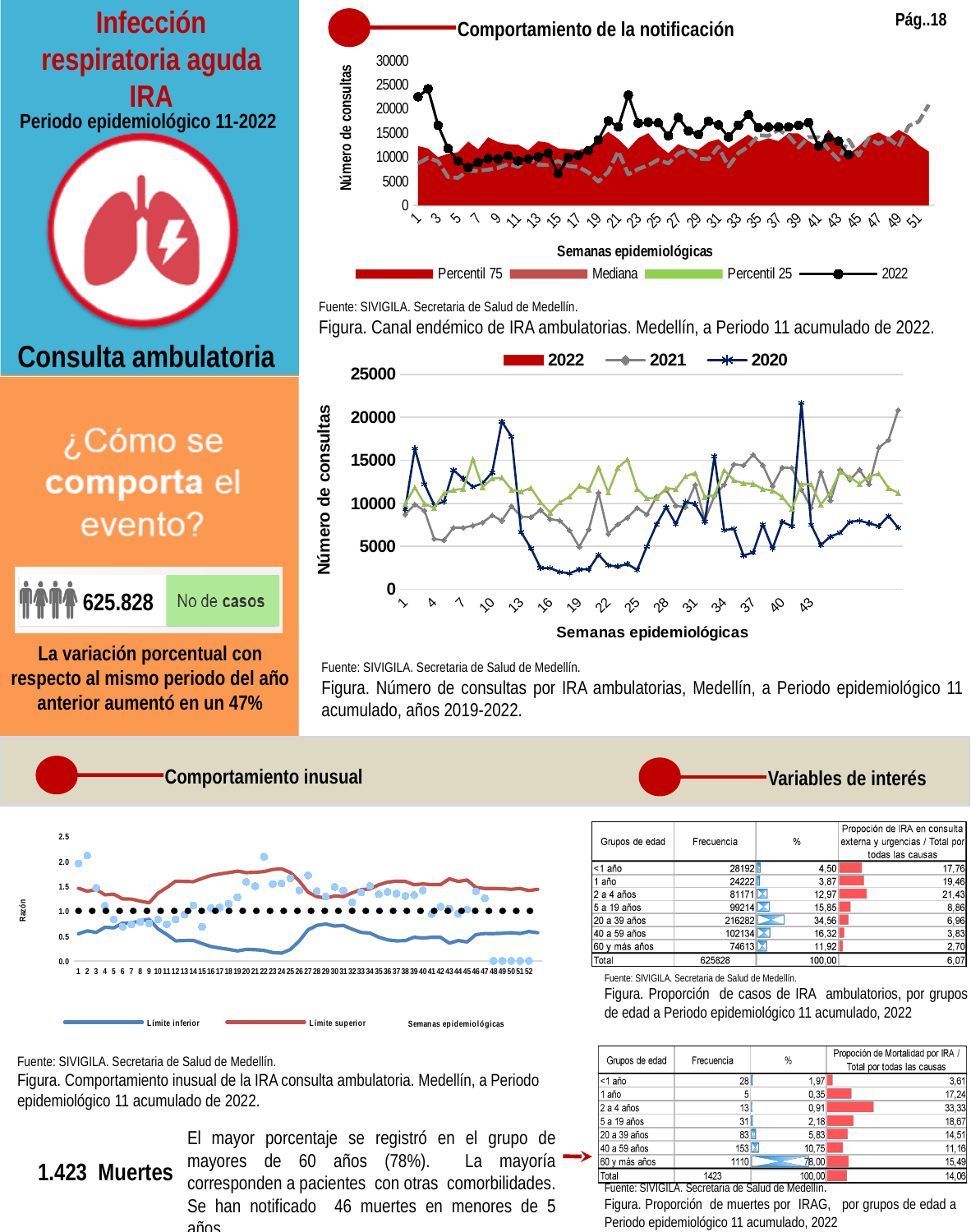
In the chart titled 'Comportamiento de la notificación' (top right), what is the label of the y axis? Número de consultas In the chart titled 'Comportamiento de la notificación' (top right), how many series does the legend list? 4 In the chart titled 'Comportamiento de la notificación' (top right), is the 2022 value at week 15 greater or less than 10000? less In the chart titled 'Comportamiento de la notificación' (top right), is the 2022 value at week 22 greater or less than 20000? greater In the chart with legend entries 2022, 2021 and 2020 (middle right), what kind of chart is it? line chart In the figure 'Proporción de casos de IRA ambulatorios, por grupos de edad' (bottom right), which age group has the highest frequency? 20 a 39 años In the chart with legend entries 2022, 2021 and 2020 (middle right), is the 2020 value at week 19 greater or less than 5000? less In the figure 'Proporción de muertes por IRAG, por grupos de edad' (bottom right), what is the percentage for the group '60 y más años'? 78,00 In the chart with legend entries 2022, 2021 and 2020 (middle right), how many series does the legend list? 3 In the 'Comportamiento inusual' chart (bottom left), what are the two legend entries? Límite inferior, Límite superior In the 'Comportamiento inusual' chart (bottom left), how many epidemiological weeks are shown on the x axis? 52